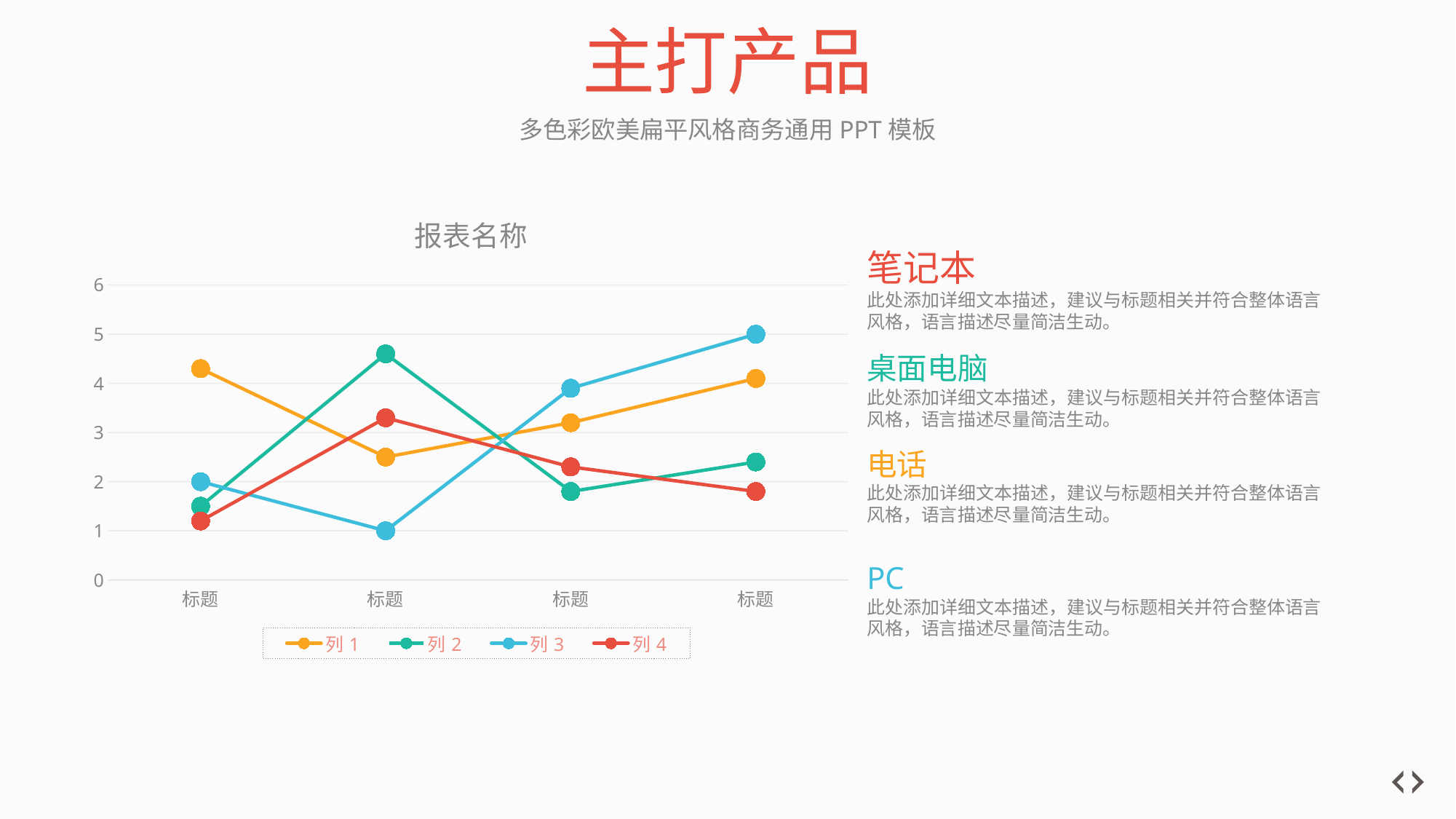
What is the value of 列 3 at the fourth (rightmost) category? 5 What kind of chart is shown on the slide? line chart What is the value of 列 3 at the second category? 1 What is the title of the chart? 报表名称 Does 列 3 rise or fall from the second category to the fourth category? rise How many series does the chart legend list? 4 Which series has the lowest value at the second category? 列 3 Which series has the highest value at the second category? 列 2 Which series has the highest value at the fourth (rightmost) category? 列 3 Is the value of 列 1 at the first category greater or less than 4? greater What are the legend entries of the chart? 列 1, 列 2, 列 3, 列 4 How many categories are plotted along the x axis of the chart? 4